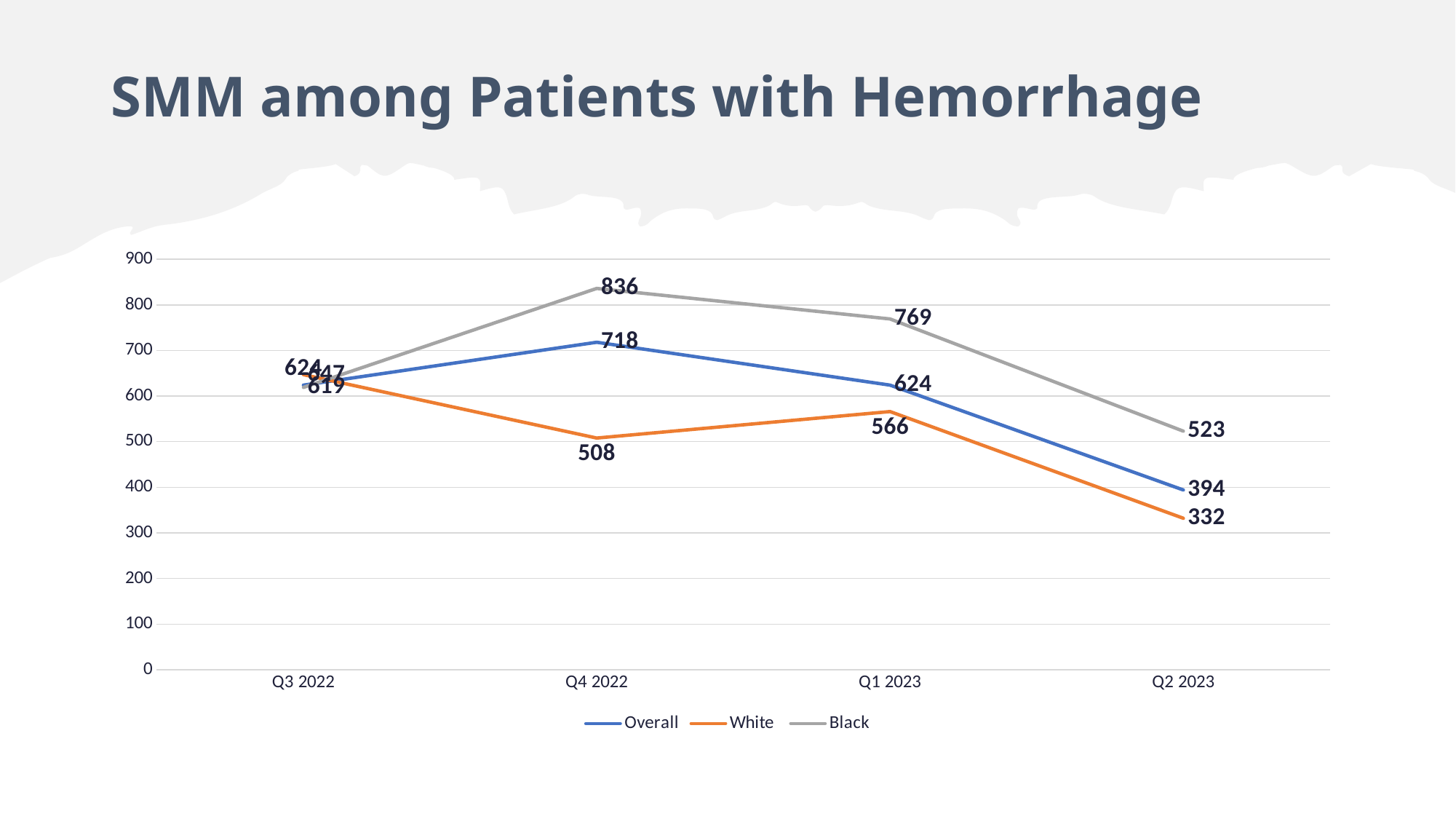
What is the value for White in Q4 2022? 508 In which quarter does the Black series reach its highest value? Q4 2022 In which quarter does the White series have its lowest value? Q2 2023 What is the value for Overall in Q1 2023? 624 What is the value for Black in Q2 2023? 523 How many series does the legend list? 3 Is the value for Black in Q1 2023 greater or less than 700? greater What is the difference between the Black and White values in Q4 2022? 328 What kind of chart is shown on the slide? Line chart What is the value for Black in Q4 2022? 836 Which is larger in Q2 2023, the Overall value or the White value? Overall How many quarters are shown on the x axis? 4